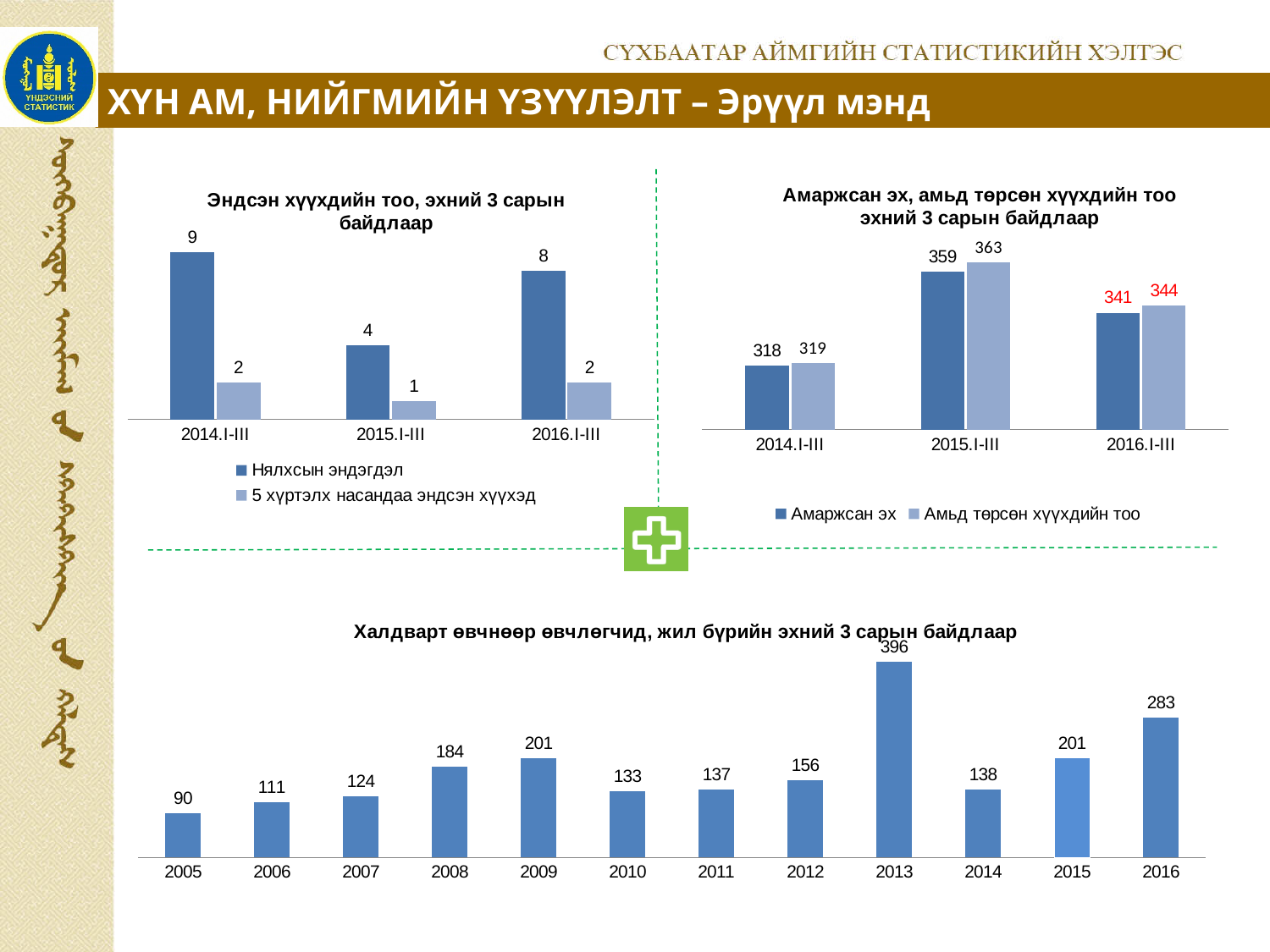
In the top-right chart 'Амаржсан эх, амьд төрсөн хүүхдийн тоо эхний 3 сарын байдлаар', which period has the highest value for 'Амаржсан эх'? 2015.I-III In the bottom chart 'Халдварт өвчнөөр өвчлөгчид, жил бүрийн эхний 3 сарын байдлаар', which year has the lowest value? 2005 In the bottom chart 'Халдварт өвчнөөр өвчлөгчид, жил бүрийн эхний 3 сарын байдлаар', what is the value for 2013? 396 In the bottom chart 'Халдварт өвчнөөр өвчлөгчид, жил бүрийн эхний 3 сарын байдлаар', what is the difference between the values for 2016 and 2015? 82 What type of chart is the bottom chart 'Халдварт өвчнөөр өвчлөгчид, жил бүрийн эхний 3 сарын байдлаар'? Bar chart In the top-left chart 'Эндсэн хүүхдийн тоо, эхний 3 сарын байдлаар', how many series does the legend list? 2 In the bottom chart 'Халдварт өвчнөөр өвчлөгчид, жил бүрийн эхний 3 сарын байдлаар', how many years are shown on the x axis? 12 In the top-right chart 'Амаржсан эх, амьд төрсөн хүүхдийн тоо эхний 3 сарын байдлаар', what is the value of 'Амьд төрсөн хүүхдийн тоо' for 2016.I-III? 344 In the bottom chart 'Халдварт өвчнөөр өвчлөгчид, жил бүрийн эхний 3 сарын байдлаар', which is larger, the value for 2008 or the value for 2012? 2008 In the top-left chart 'Эндсэн хүүхдийн тоо, эхний 3 сарын байдлаар', what is the value of 'Нялхсын эндэгдэл' for 2015.I-III? 4 In the top-right chart 'Амаржсан эх, амьд төрсөн хүүхдийн тоо эхний 3 сарын байдлаар', what is the difference between 'Амаржсан эх' in 2015.I-III and 2014.I-III? 41 In the top-left chart 'Эндсэн хүүхдийн тоо, эхний 3 сарын байдлаар', which period has the highest value for 'Нялхсын эндэгдэл'? 2014.I-III